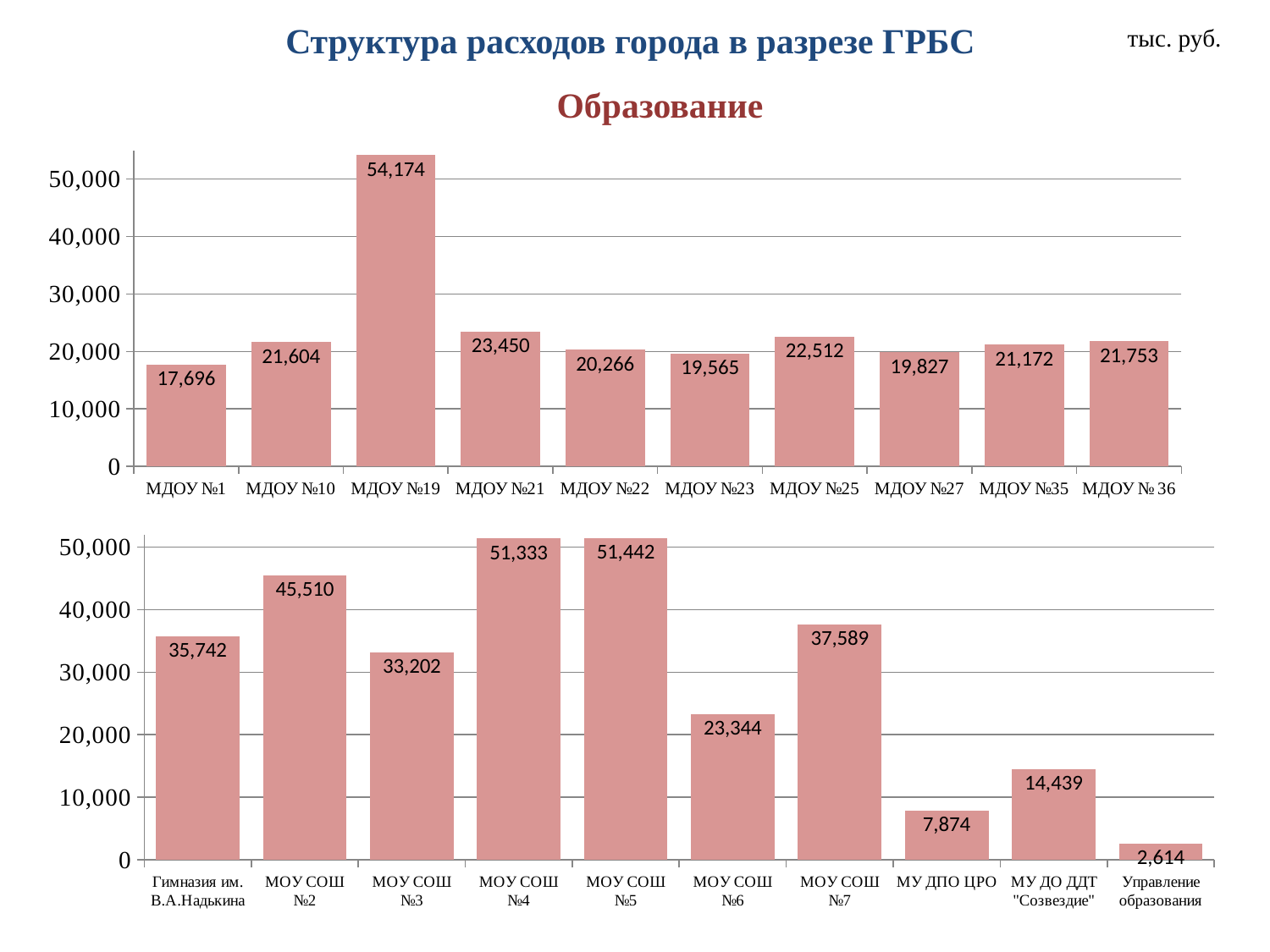
In the top chart, what is the difference between the values for МДОУ №21 and МДОУ №1? 5,754 In the bottom chart, which is larger: the value for МОУ СОШ №2 or МОУ СОШ №7? МОУ СОШ №2 In the bottom chart, what is the value for МУ ДО ДДТ "Созвездие"? 14,439 In the top chart, what is the value for МДОУ №19? 54,174 In the top chart, what is the value for МДОУ №23? 19,565 In the bottom chart, what is the difference between the values for МОУ СОШ №5 and МОУ СОШ №6? 28,098 In the top chart, which category has the lowest value? МДОУ №1 In the top chart, how many categories are shown? 10 What is the subtitle shown above the charts? Образование What kind of chart is the bottom chart? bar chart In the bottom chart, which category has the lowest value? Управление образования In the bottom chart, is the value for МУ ДПО ЦРО greater or less than 10,000? less